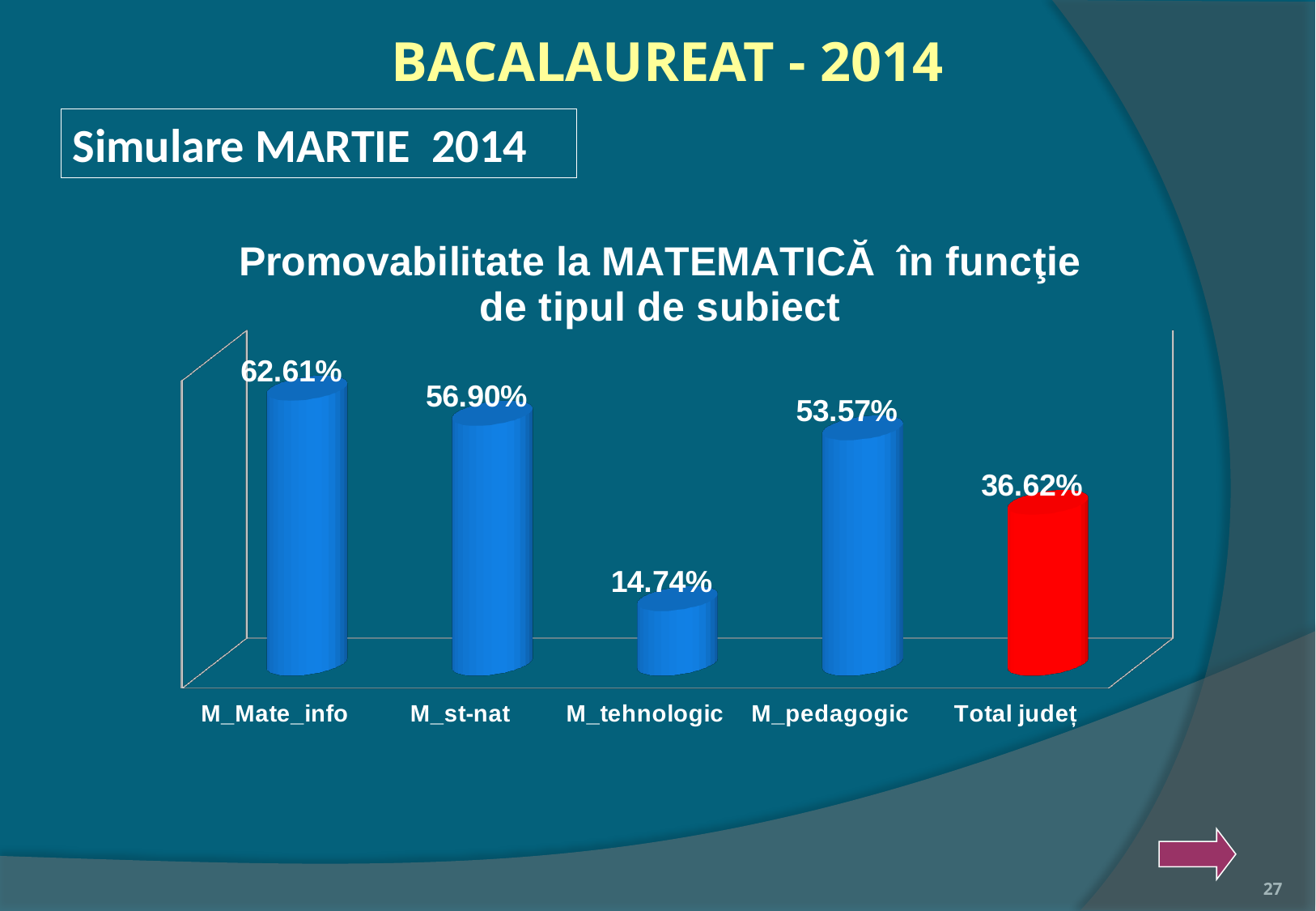
Which bar is coloured red? Total județ What is the value for Total județ? 36.62% What is the difference between the values for M_pedagogic and Total județ? 16.95% What kind of chart is shown on the slide? bar chart Which is larger, the value for M_st-nat or the value for M_pedagogic? M_st-nat What is the value for M_tehnologic? 14.74% What is the value for M_Mate_info? 62.61% Which category has the highest value? M_Mate_info What is the value for M_pedagogic? 53.57% Which category has the lowest value? M_tehnologic How many categories are shown on the x axis? 5 What is the difference between the values for M_Mate_info and M_st-nat? 5.71%